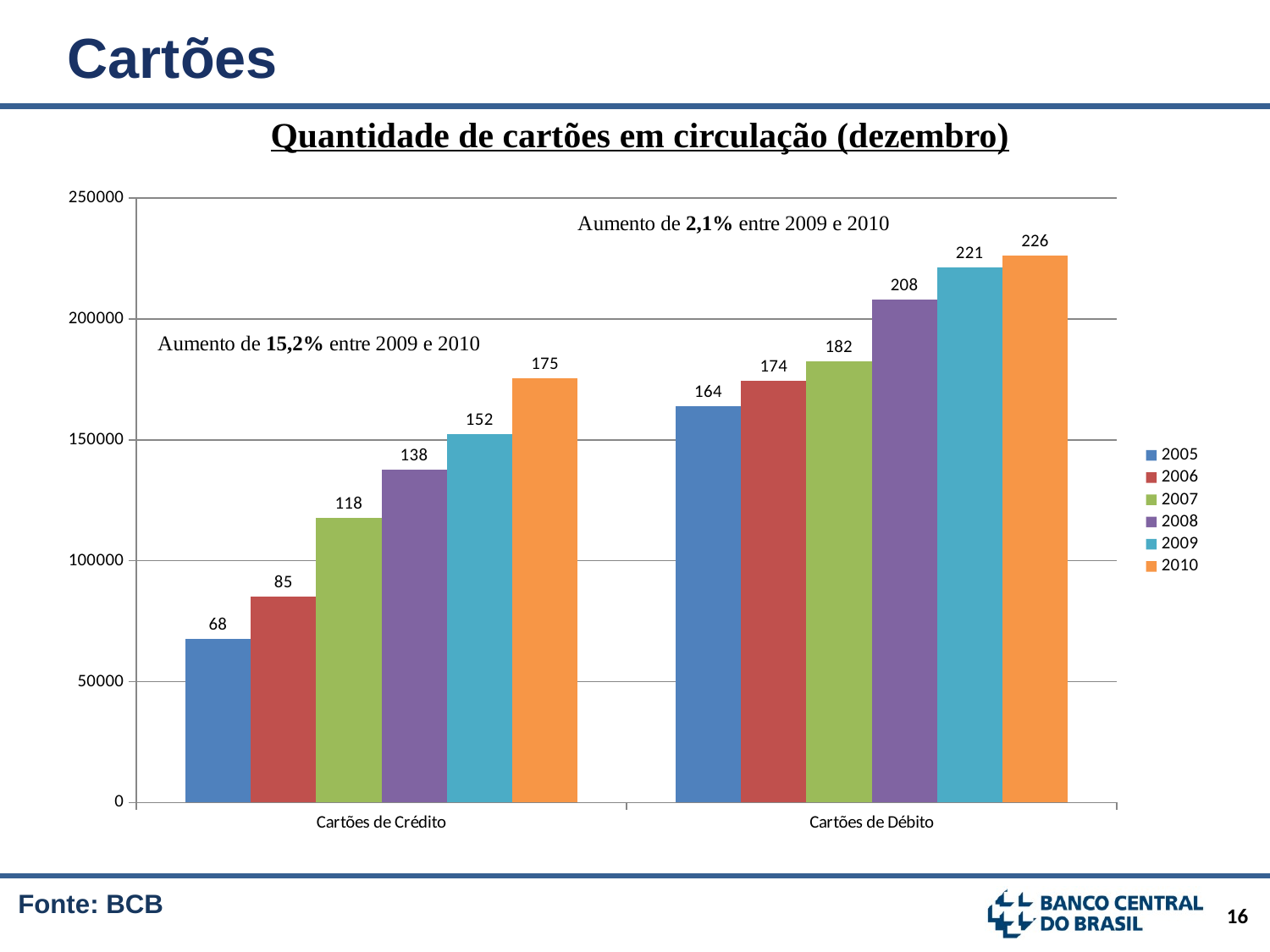
Which year has the highest value for Cartões de Crédito? 2010 What is the data label for Cartões de Débito in 2010? 226 What is the difference between the 2010 and 2009 data labels for Cartões de Crédito? 23 What is the data label for Cartões de Crédito in 2005? 68 How many series does the legend list? 6 What kind of chart is shown on the slide? bar chart Which is larger: the 2009 value for Cartões de Crédito or the 2005 value for Cartões de Débito? Cartões de Débito 2005 Is the 2006 bar for Cartões de Crédito greater or less than 100000 on the axis? less Which year has the lowest value for Cartões de Débito? 2005 What is the data label for Cartões de Crédito in 2008? 138 What is the data label for Cartões de Débito in 2007? 182 Do the values for Cartões de Débito rise or fall from 2005 to 2010? rise